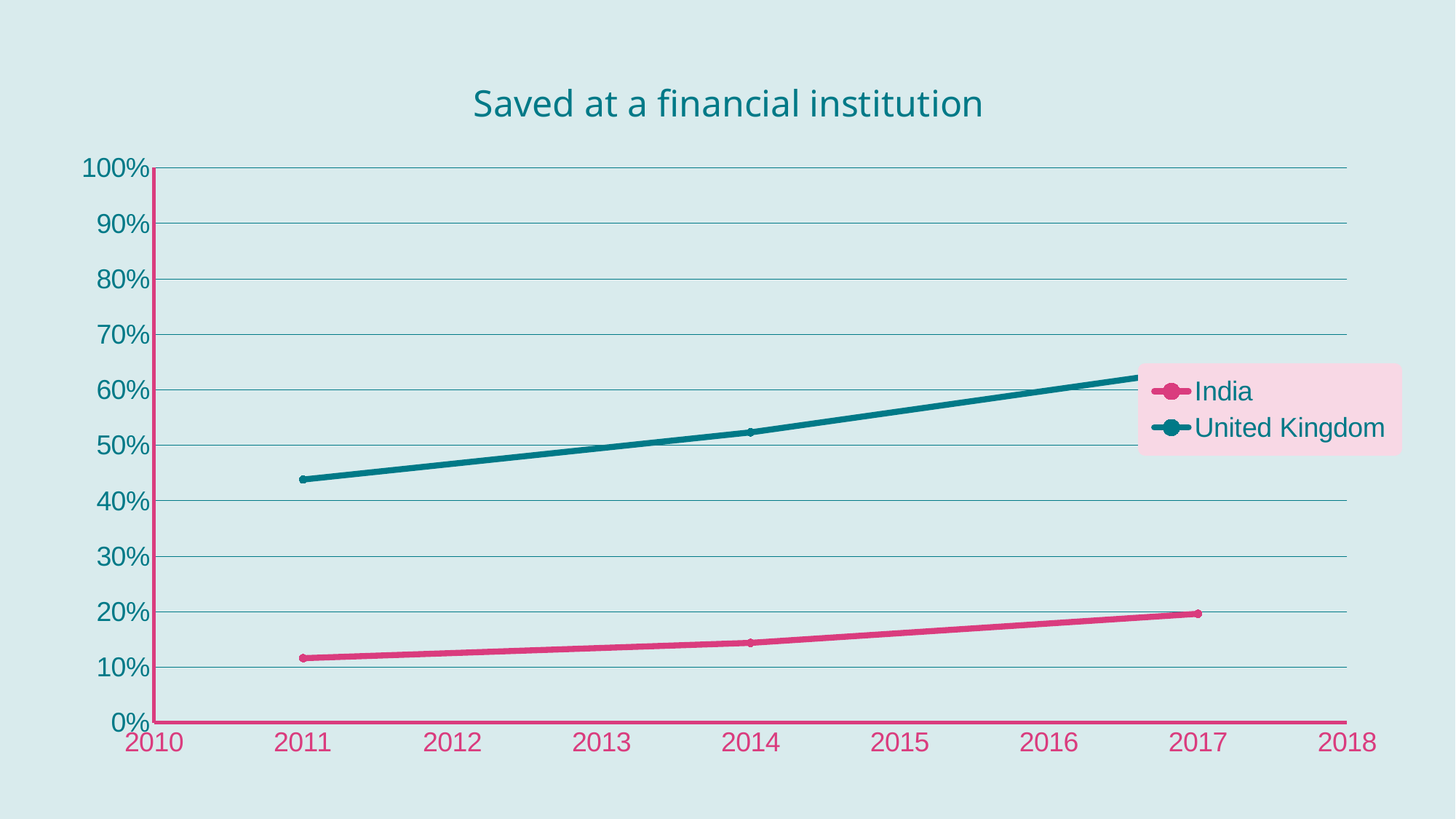
How many data points are plotted for the India series? 3 What kind of chart is shown on the slide? line chart Do the values for India rise or fall from 2011 to 2017? rise Is the value for India in 2011 greater or less than 20%? less Which series are listed in the legend? India and United Kingdom Do the values for the United Kingdom rise or fall from 2011 to 2017? rise Is the value for the United Kingdom in 2011 greater or less than 40%? greater Is the value for the United Kingdom in 2014 greater or less than 60%? less What is the title of the chart? Saved at a financial institution Which series has the higher value in 2014, India or United Kingdom? United Kingdom How many series does the legend list? 2